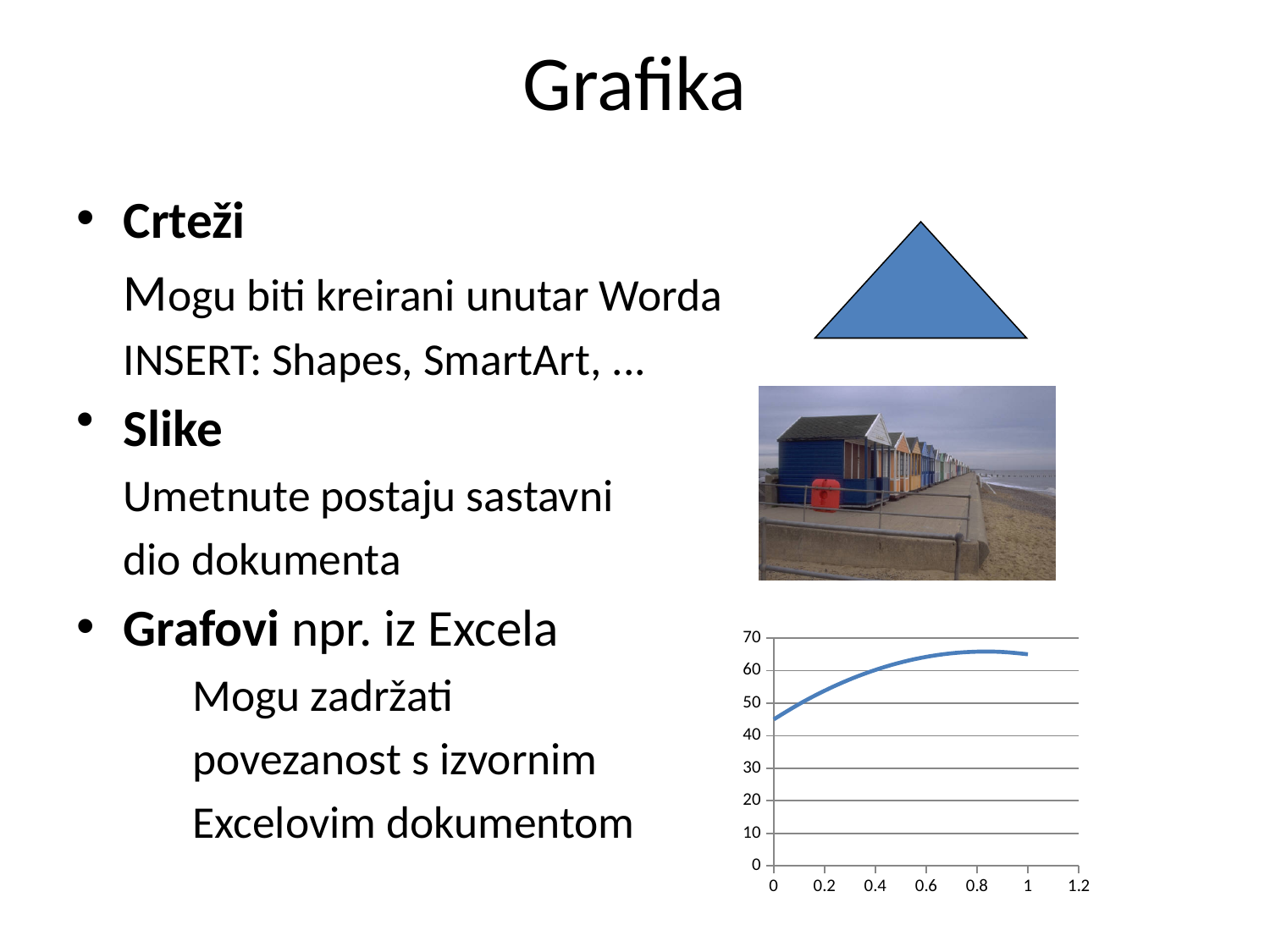
In the chart at the bottom right, is the value at x = 0 greater or less than 40? greater In the chart at the bottom right, is the value at x = 0.8 greater or less than 60? greater In the chart at the bottom right, is the value at x = 0.4 greater or less than 50? greater What kind of chart is shown at the bottom right of the slide? line chart In the chart at the bottom right, is the value at x = 1 larger or smaller than the value at x = 0? larger What is the highest value shown on the x axis of the chart at the bottom right? 1.2 In the chart at the bottom right, does the line mainly rise or fall as x increases from 0 to 0.8? rise What is the highest value shown on the y axis of the chart at the bottom right? 70